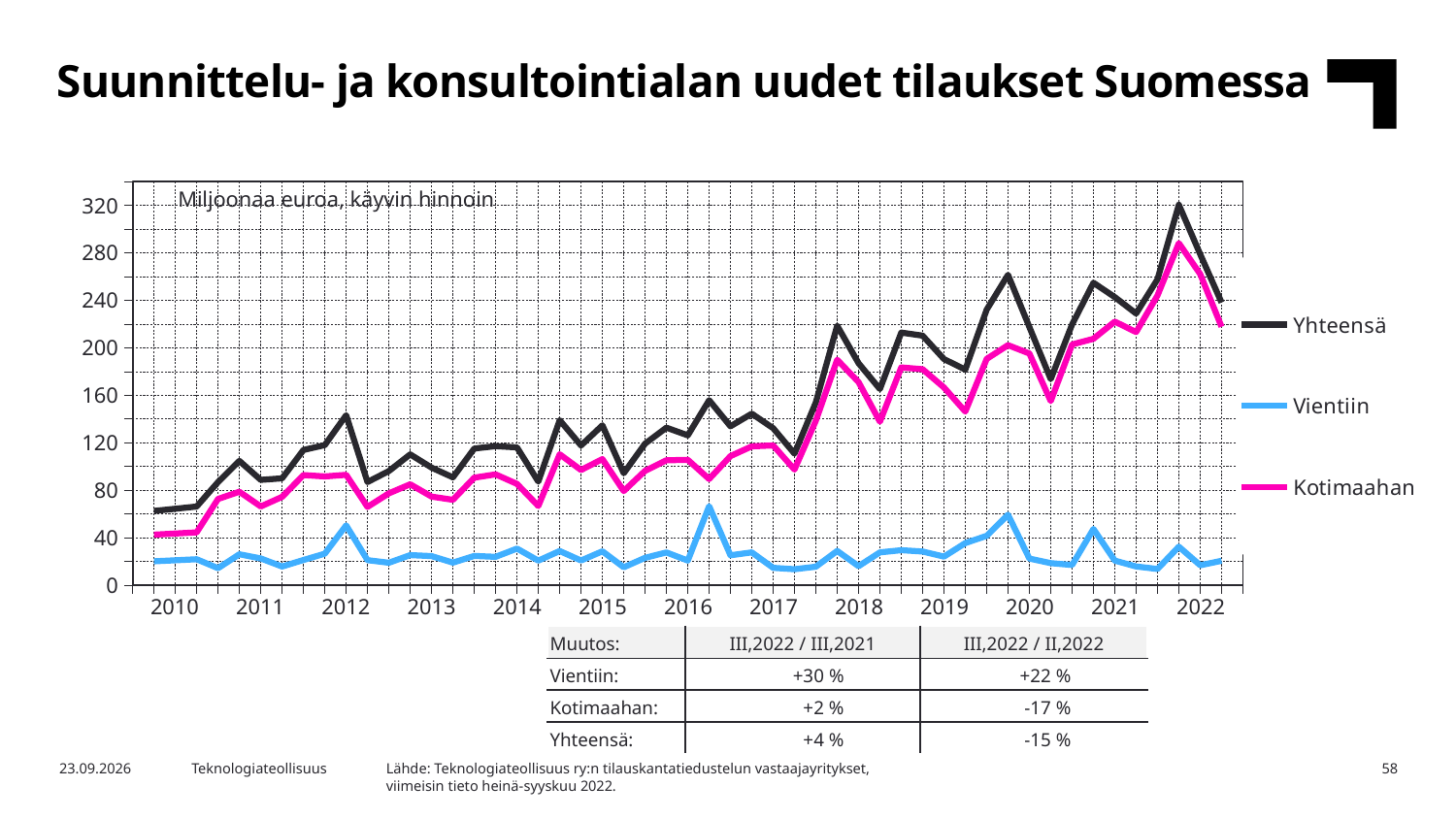
Is the value of the Yhteensä line at the start of 2010 greater or less than 80? less Is the peak value of the Yhteensä line in late 2021 greater or less than 280? greater Does the Yhteensä line overall rise or fall from 2010 to 2022? rise Is the last value of the Kotimaahan line in 2022 greater or less than 200? greater In 2020, which is larger, the Kotimaahan line or the Vientiin line? Kotimaahan Which series has the lowest values throughout the chart? Vientiin What unit is stated in the chart's subtitle? Miljoonaa euroa, käyvin hinnoin What are the three series named in the legend? Yhteensä, Vientiin, Kotimaahan Which series has the highest values throughout the chart? Yhteensä How many series does the legend list? 3 What kind of chart is shown on the slide? line chart